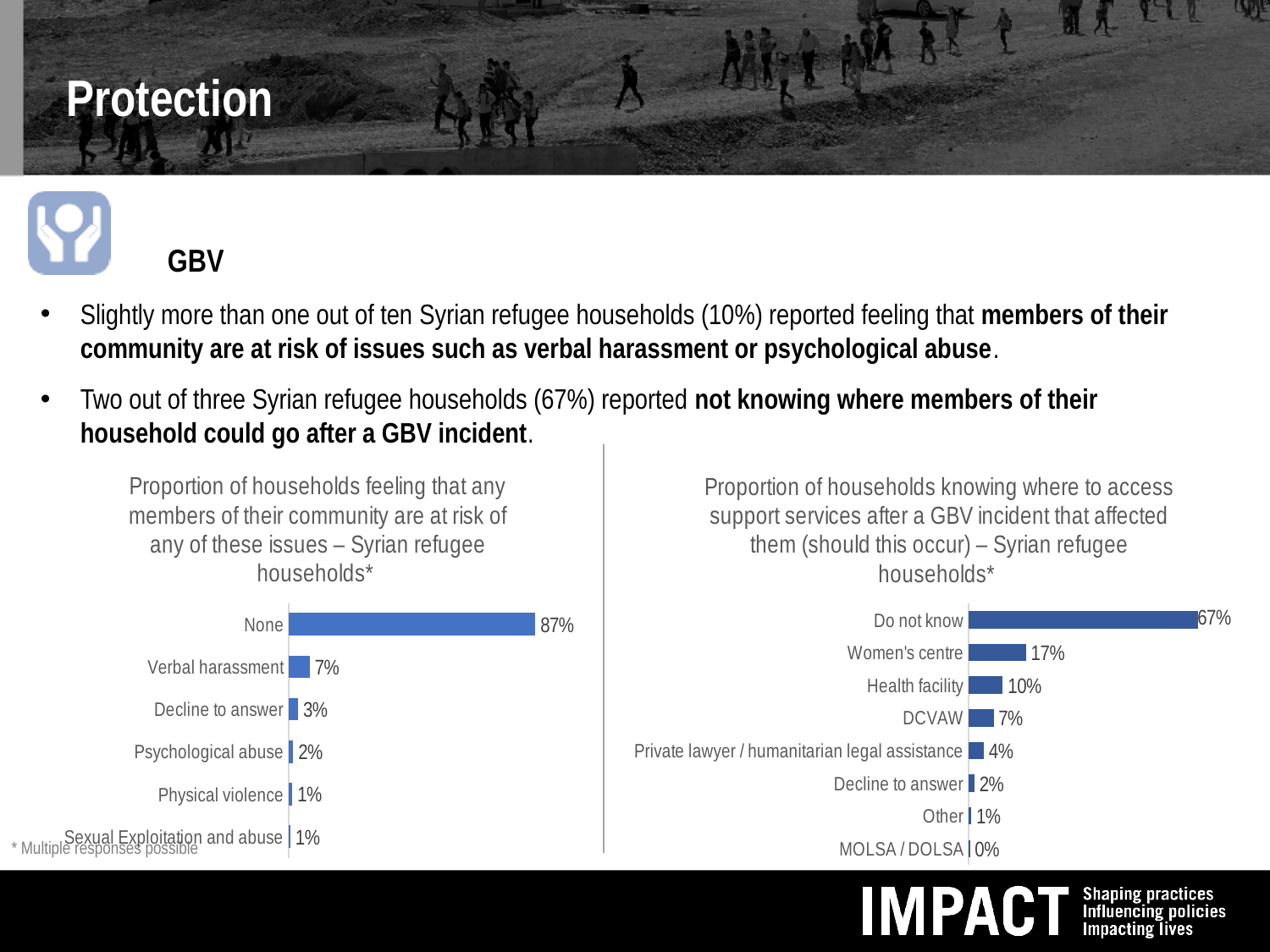
In the right chart (knowing where to access support services), which category has the lowest value? MOLSA / DOLSA In the left chart (community at risk of issues), how many categories are shown? 6 In the right chart (knowing where to access support services), what is the difference between Do not know and Women's centre? 50% In the right chart (knowing where to access support services), what is the value for Health facility? 10% In the left chart (community at risk of issues), what is the value for Verbal harassment? 7% In the right chart (Proportion of households knowing where to access support services after a GBV incident), what is the value for Women's centre? 17% In the left chart (Proportion of households feeling that any members of their community are at risk of any of these issues), what is the value for None? 87% In the right chart (knowing where to access support services), which is larger: DCVAW or Private lawyer / humanitarian legal assistance? DCVAW In the left chart (community at risk of issues), what is the difference between Verbal harassment and Psychological abuse? 5% What type of chart is the left chart (community at risk of issues)? Bar chart In the left chart (community at risk of issues), which category has the highest value? None In the right chart (knowing where to access support services), how many categories are shown? 8